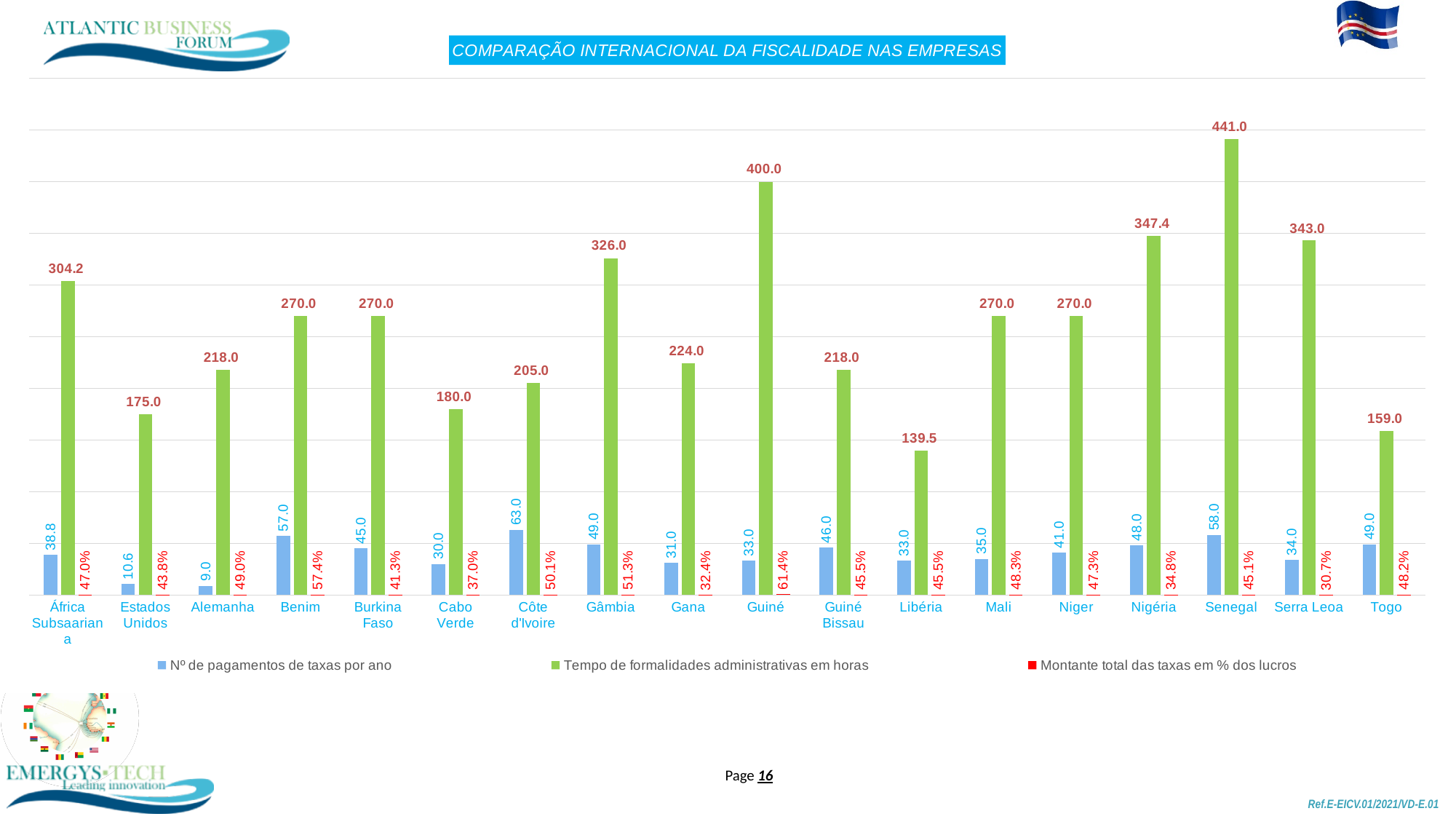
Which country has the lowest 'Montante total das taxas em % dos lucros'? Serra Leoa Which country has the lowest 'Tempo de formalidades administrativas em horas'? Libéria What is the 'Nº de pagamentos de taxas por ano' for Côte d'Ivoire? 63.0 What is the 'Montante total das taxas em % dos lucros' for Guiné? 61.4% What is the difference in 'Tempo de formalidades administrativas em horas' between Senegal and Guiné? 41.0 What is the value of 'Tempo de formalidades administrativas em horas' for Cabo Verde? 180.0 What type of chart is shown on the slide? Bar chart Which has a higher 'Nº de pagamentos de taxas por ano', Benim or Estados Unidos? Benim What is the title of the chart? COMPARAÇÃO INTERNACIONAL DA FISCALIDADE NAS EMPRESAS Which country has the highest 'Tempo de formalidades administrativas em horas'? Senegal How many series does the legend list? 3 How many countries/regions are shown on the x axis? 18